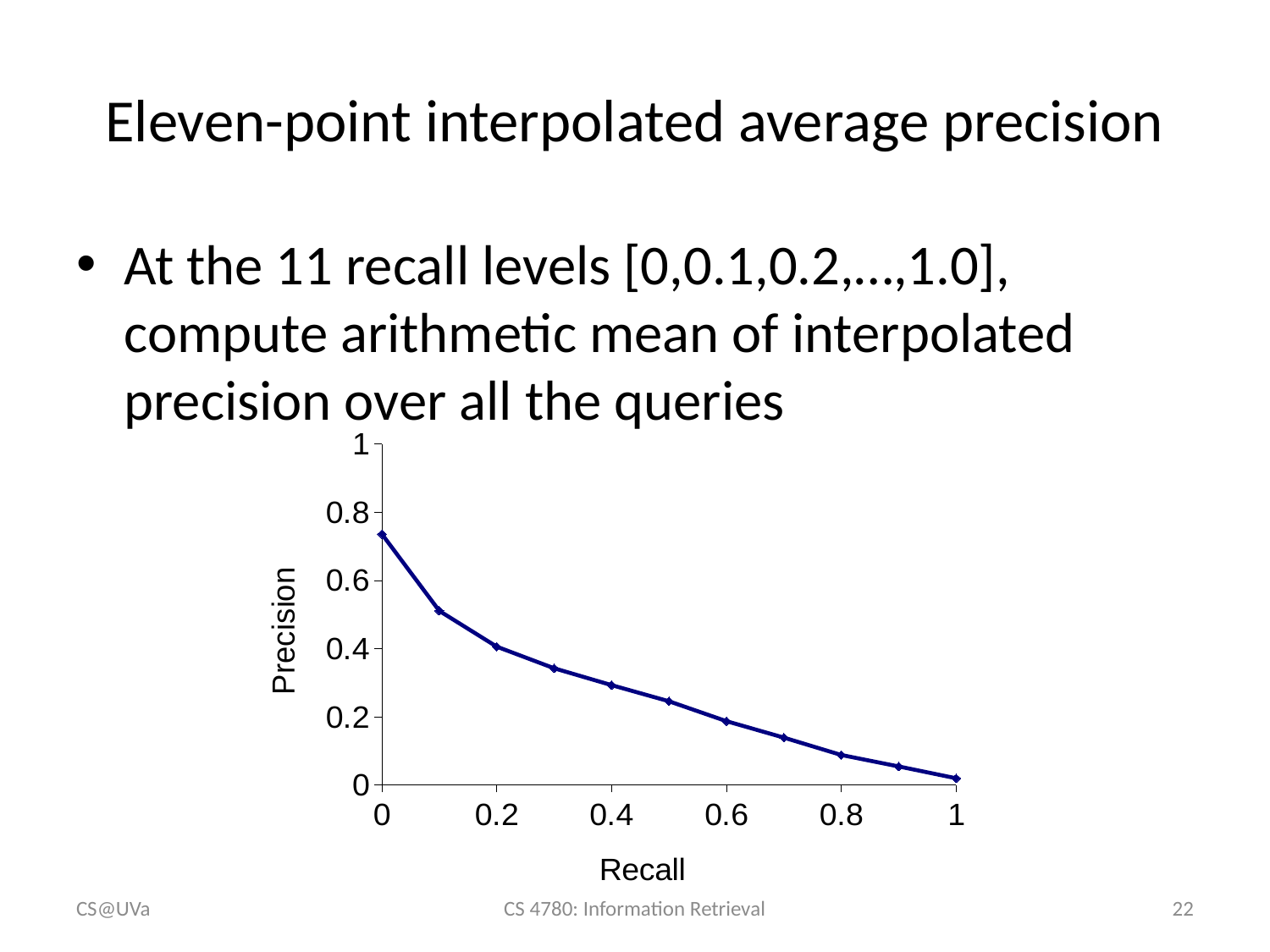
At which recall level is precision lowest? 1 Is the precision at recall 0 greater or less than 0.6? greater Is the precision at recall 0.1 greater or less than 0.4? greater Is the precision at recall 0.3 greater or less than 0.4? less How many data points are plotted on the precision-recall curve? 11 What kind of chart is shown on the slide? line chart Does precision rise or fall as recall increases along the x axis? fall At which recall level is precision highest? 0 Which has the higher precision: recall 0.2 or recall 0.8? recall 0.2 What is the label of the y axis? Precision What is the label of the x axis? Recall